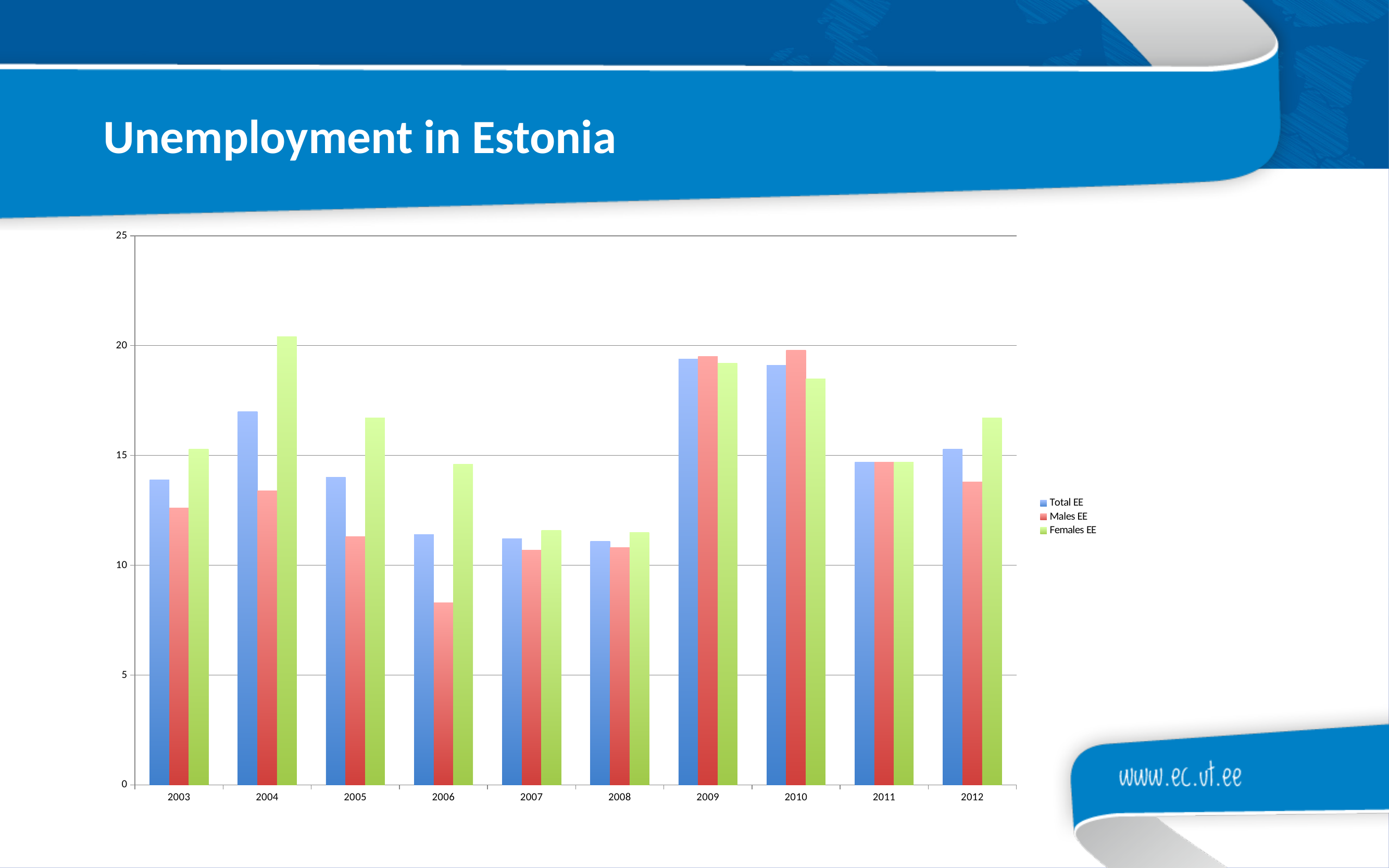
Which series is shown in green in the legend? Females EE Is the value for Females EE in 2004 greater or less than 20? greater How many years are shown on the x axis of the chart? 10 In which year is the Males EE bar the lowest? 2006 In which year is the Females EE bar the highest? 2004 How many series does the chart's legend list? 3 In 2006, which is larger: Males EE or Females EE? Females EE Does the Total EE value rise or fall from 2004 to 2008? fall Is the value for Males EE in 2006 greater or less than 10? less What kind of chart is shown on the slide? bar chart Is the value for Total EE in 2004 greater or less than 15? greater In 2010, which is larger: Males EE or Females EE? Males EE